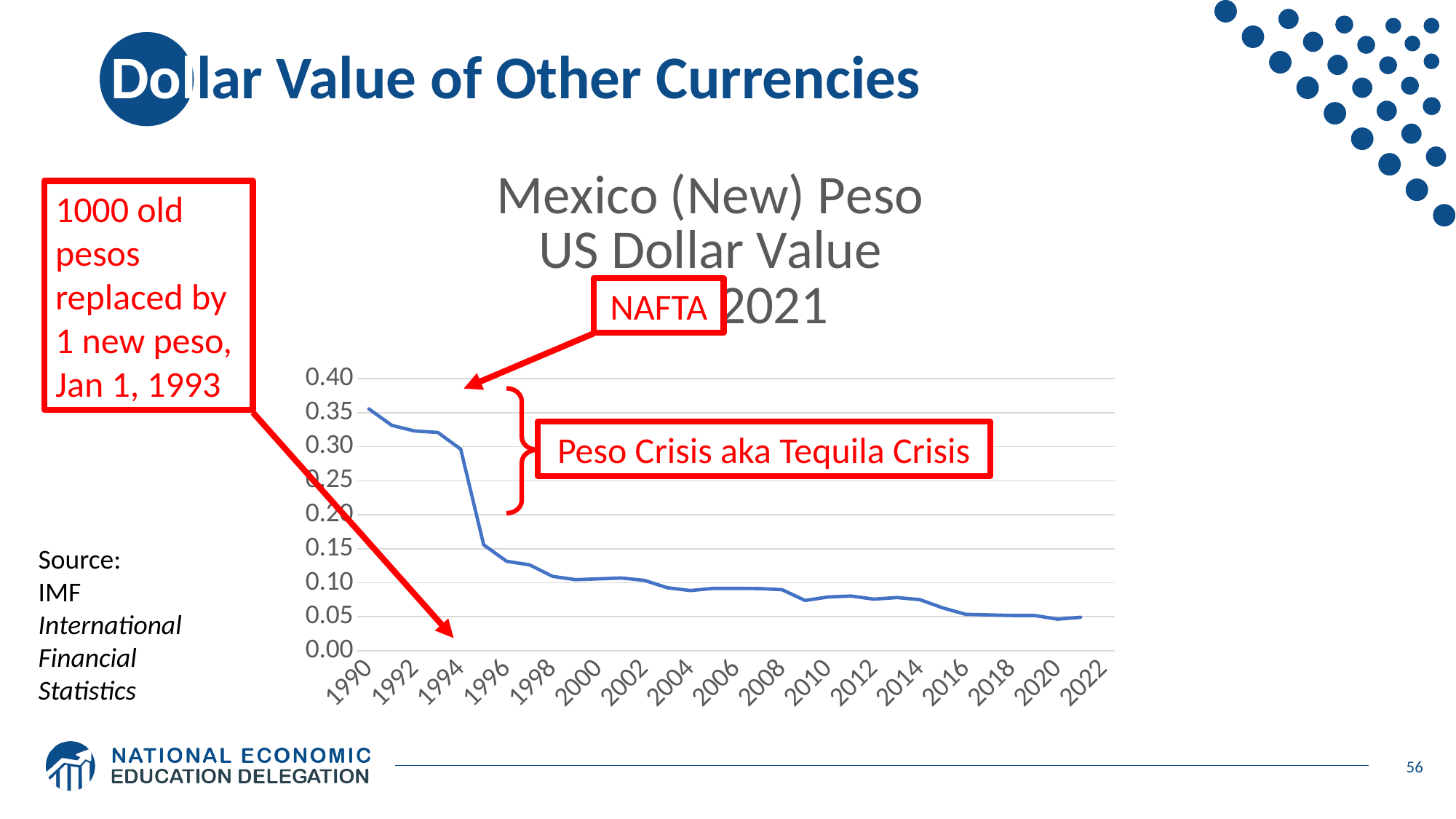
What event does the annotation label the sharp drop in the mid-1990s as? Peso Crisis aka Tequila Crisis What kind of chart is shown on the slide? line chart Is the value for 2000 greater or less than 0.05? greater Which year has the highest US dollar value of the peso on the chart? 1990 How many lines are plotted on the chart? 1 Is the value for 2010 greater or less than 0.10? less What is the title of the chart? Mexico (New) Peso US Dollar Value 1990-2021 Is the value for 1996 greater or less than 0.20? less Which is larger, the value for 1990 or the value for 2010? 1990 Does the US dollar value of the Mexican peso rise or fall overall from 1990 to 2021? fall